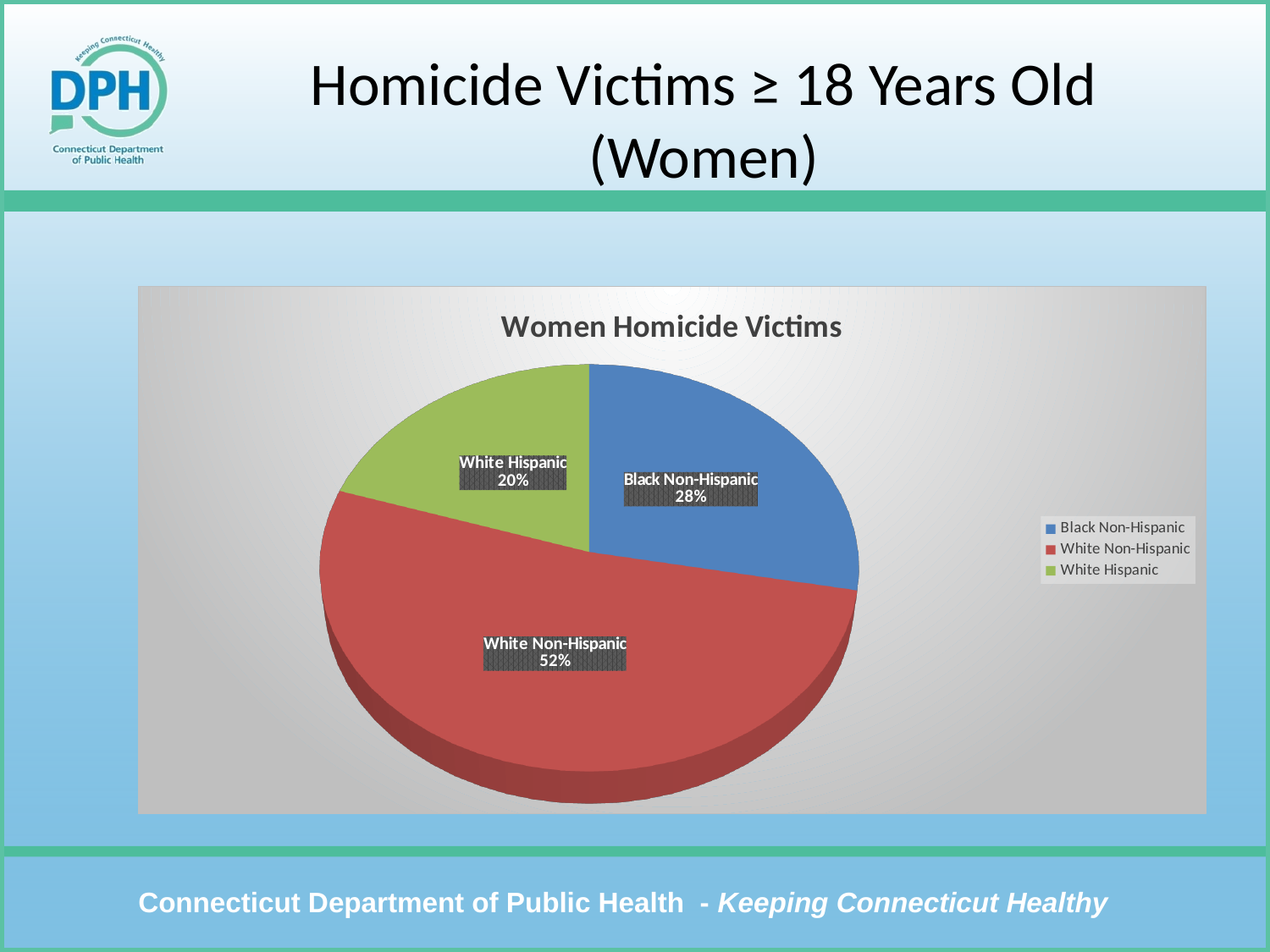
What is the title of the chart? Women Homicide Victims What colour represents White Non-Hispanic in the chart? Red Which is larger, the Black Non-Hispanic share or the White Hispanic share? Black Non-Hispanic What share of women homicide victims are White Non-Hispanic? 52% Which category has the largest share of the pie? White Non-Hispanic What is the difference in percentage points between the Black Non-Hispanic and White Hispanic shares? 8 percentage points How many categories are shown in the pie chart? 3 Which category has the smallest share of the pie? White Hispanic What share of women homicide victims are White Hispanic? 20% What share of women homicide victims are Black Non-Hispanic? 28% What kind of chart is shown on the slide? Pie chart What is the difference in percentage points between the White Non-Hispanic and Black Non-Hispanic shares? 24 percentage points